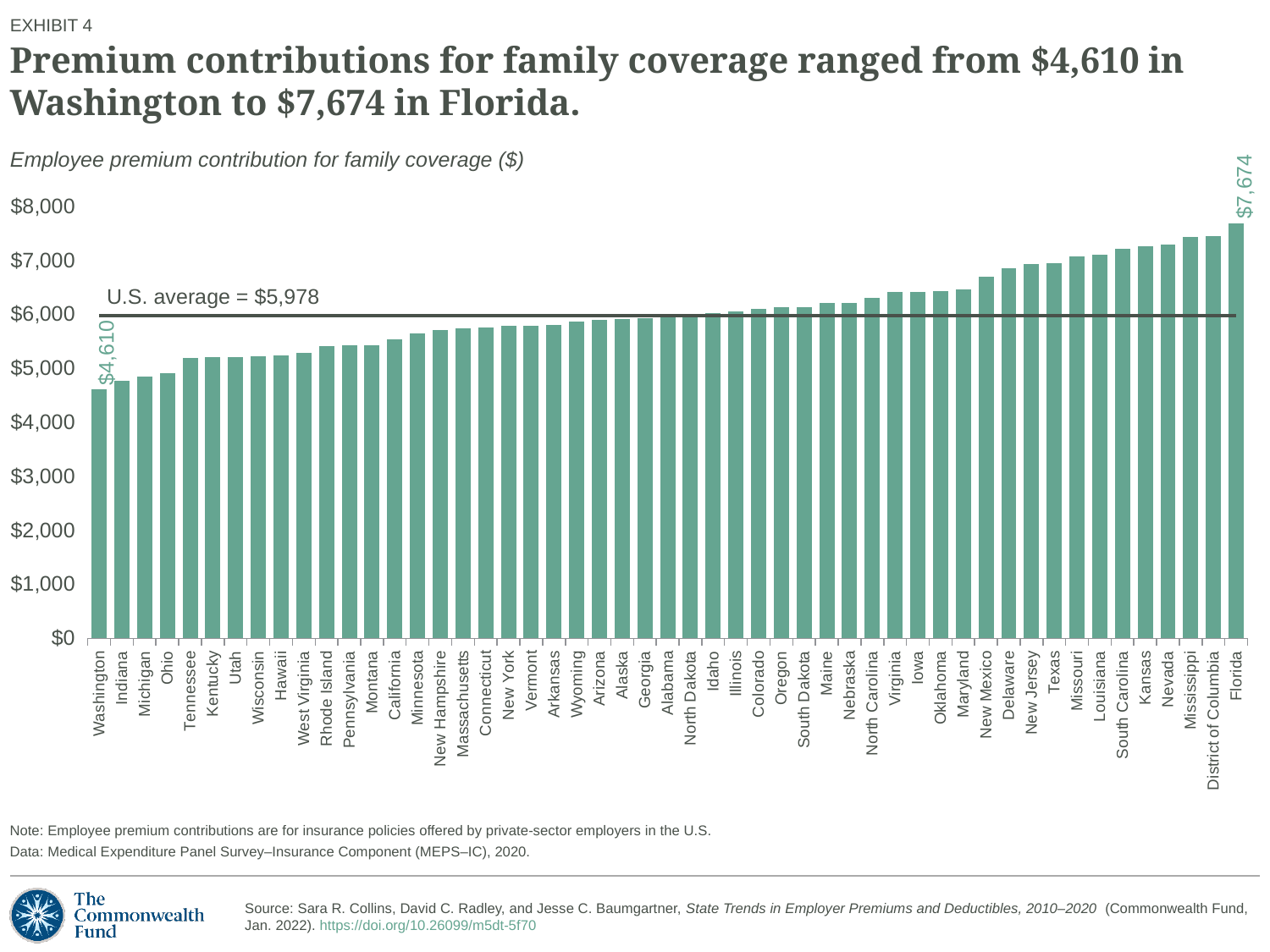
What kind of chart is shown on the slide? Bar chart Is the value for Indiana greater or less than $5,000? less Is the value for Texas greater or less than $6,000? greater Which state has the highest employee premium contribution for family coverage? Florida Which state has the lowest employee premium contribution for family coverage? Washington Do the values rise or fall moving from left to right along the x axis? Rise What is the U.S. average employee premium contribution for family coverage shown on the chart? $5,978 Which has a larger premium contribution, Nevada or Michigan? Nevada What is the employee premium contribution for family coverage in Washington? $4,610 Is the value for Mississippi greater or less than $7,000? greater What is the difference between the premium contribution in Florida and in Washington? $3,064 What is the employee premium contribution for family coverage in Florida? $7,674